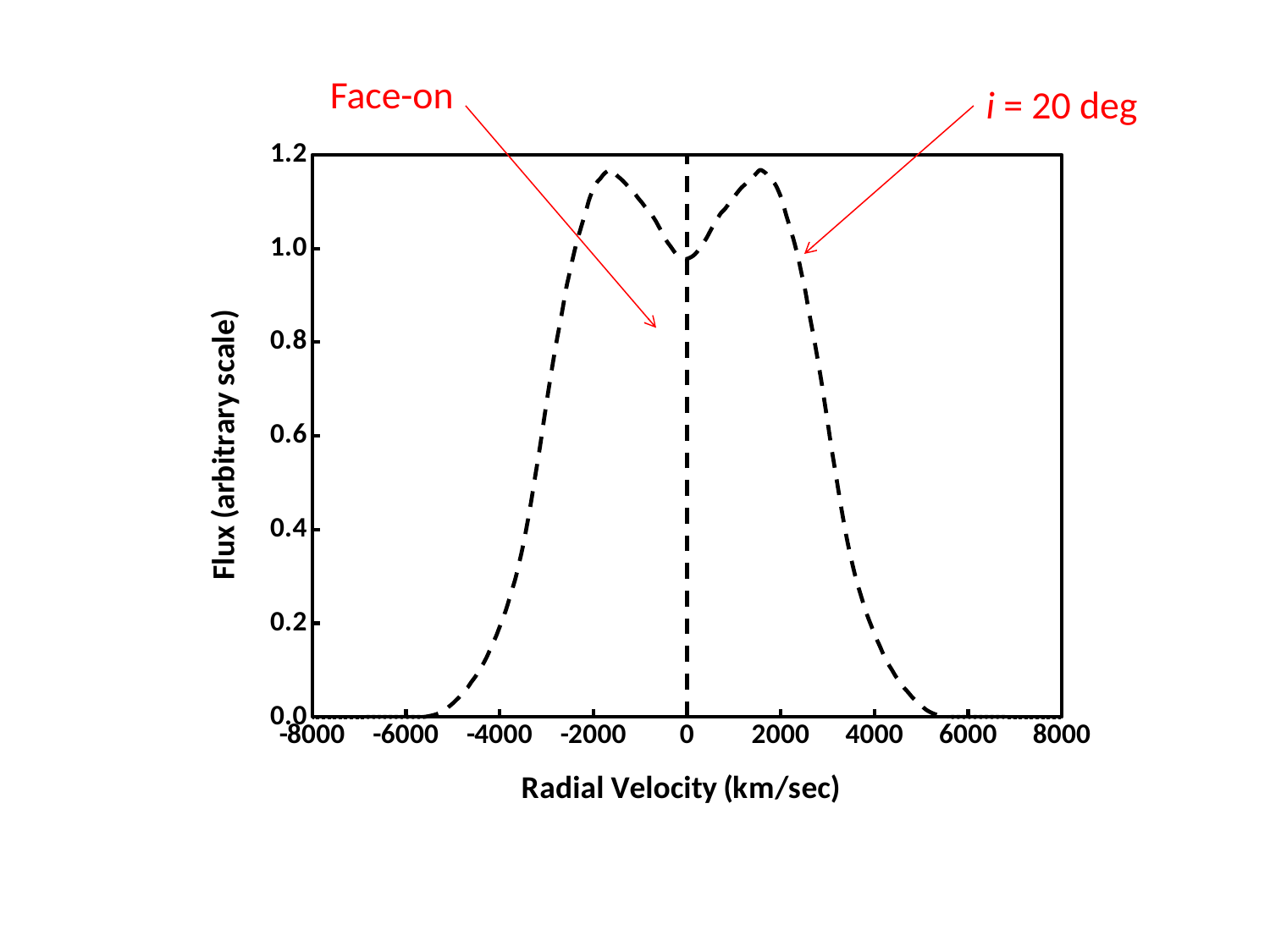
Is the flux of the i = 20 deg curve at a radial velocity of 4000 km/sec greater or less than 0.4? less What is the label of the y axis? Flux (arbitrary scale) What kind of chart is shown on the slide? line chart At what radial velocity is the Face-on curve located? 0 Is the flux of the i = 20 deg curve at a radial velocity of -6000 km/sec greater or less than 0.2? less Does the i = 20 deg curve rise or fall as radial velocity increases from -6000 to -2000 km/sec? rise How many curves are annotated on the chart? 2 Is the peak flux of the i = 20 deg curve greater or less than 1.0? greater What is the label of the x axis? Radial Velocity (km/sec) Does the i = 20 deg curve rise or fall as radial velocity increases from 2000 to 6000 km/sec? fall What is the highest value shown on the y axis? 1.2 How many tick labels are shown on the x axis? 9